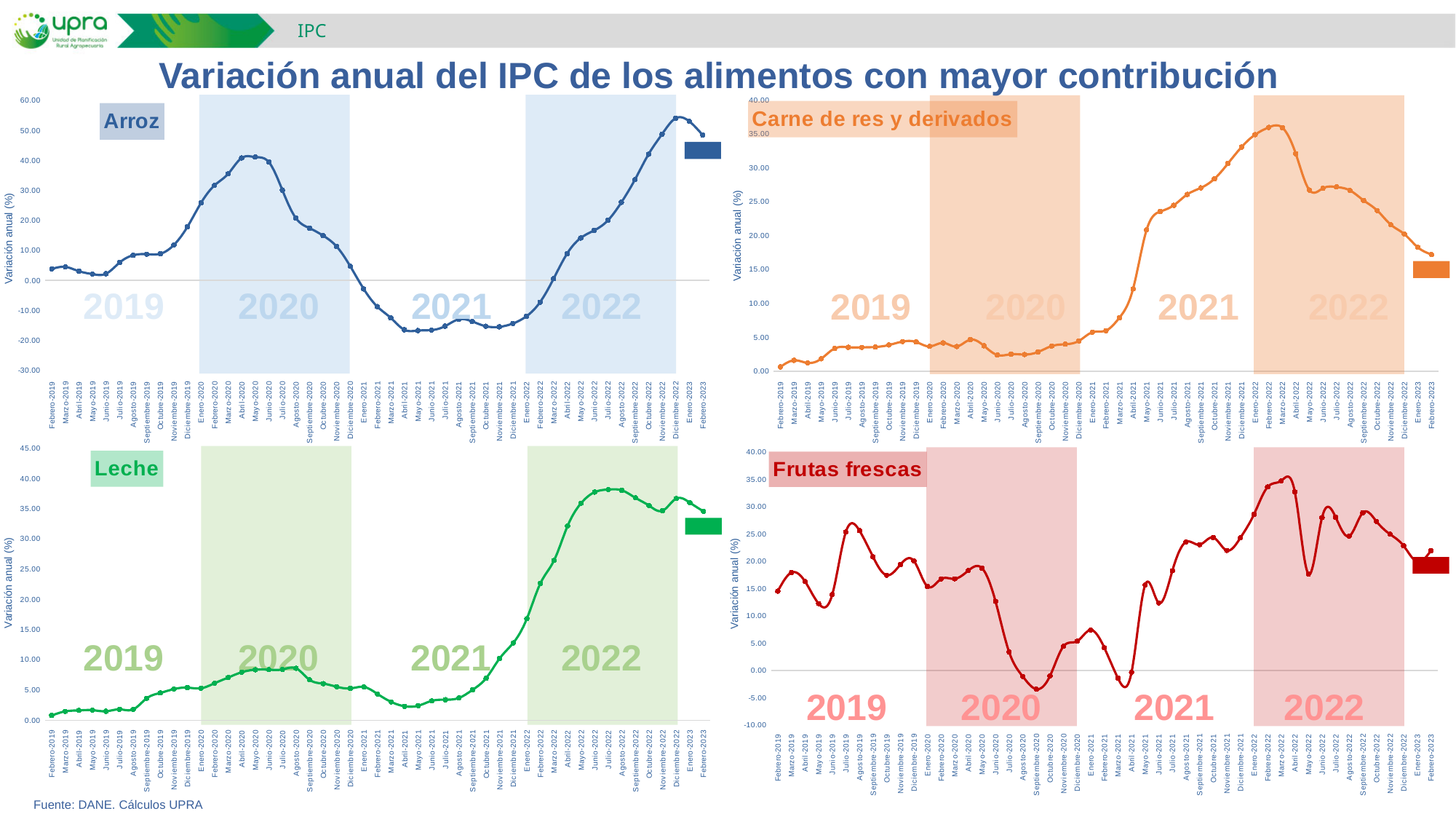
In the Arroz chart, does the line rise or fall from Abril-2020 to Mayo-2021? fall In the Leche chart, which is larger, the value for Agosto-2019 or the value for Agosto-2022? Agosto-2022 In the Carne de res y derivados chart, is the value for Febrero-2022 greater or less than 30.00? greater In the Arroz chart, in which year does the line reach its highest point? 2022 What kind of chart is the Arroz chart? line chart In the Frutas frescas chart, is the value for Marzo-2022 greater or less than 30.00? greater In the Frutas frescas chart, is the value for Septiembre-2020 greater or less than 0.00? less How many charts are shown on the slide? 4